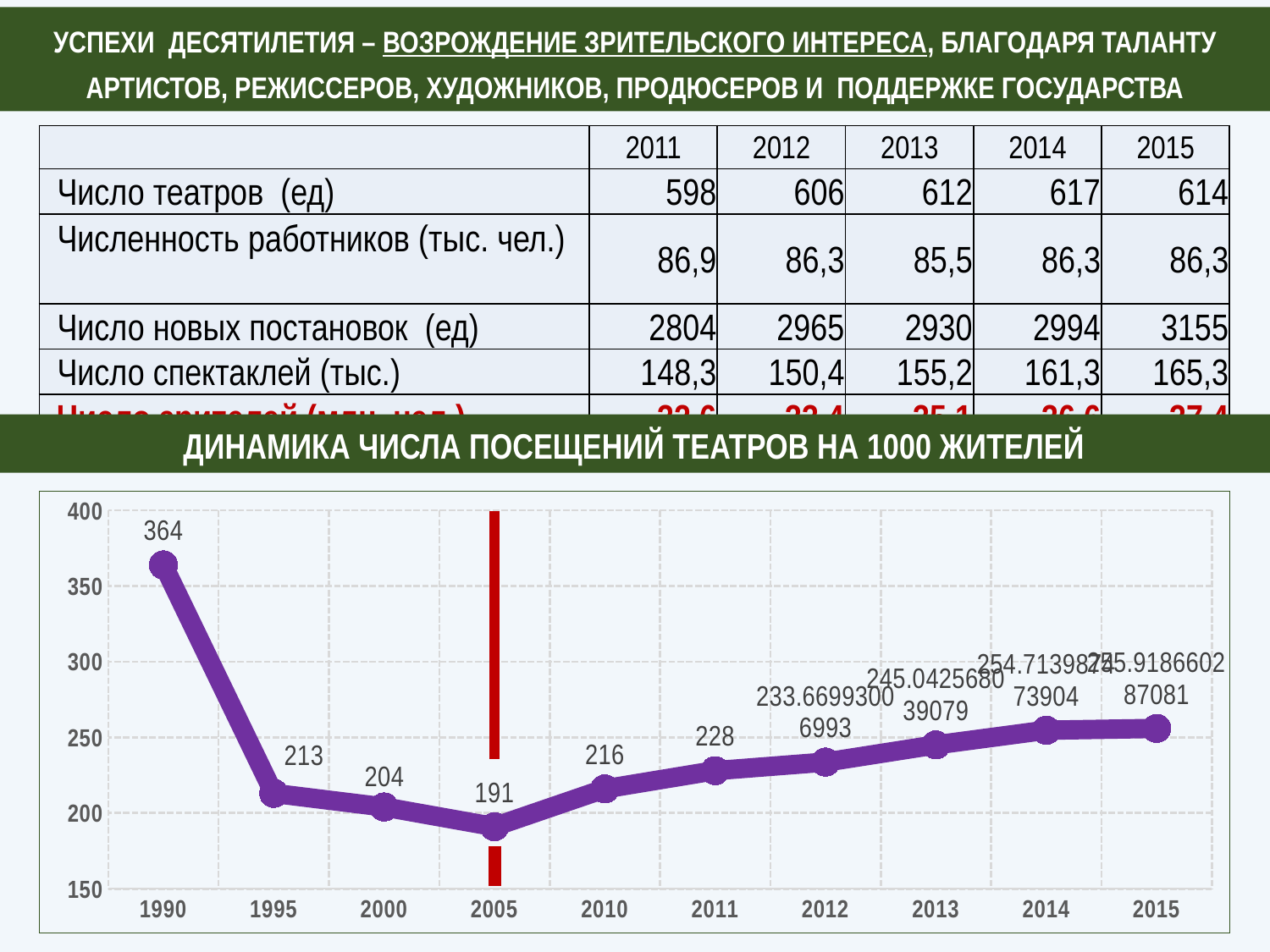
What is the difference between the values for 1990 and 1995? 151 Which year has the highest value on the line chart? 1990 How many years are plotted on the line chart? 10 Is the value for 2015 greater or less than 250? greater What is the value for 1990 on the line chart? 364 What is the value for 2000 on the line chart? 204 Which is larger, the value for 2010 or the value for 2000? 2010 What is the value for 2011 on the line chart? 228 What is the value for 2005 on the line chart? 191 What is the difference between the values for 2011 and 2010? 12 What kind of chart is shown under the heading 'ДИНАМИКА ЧИСЛА ПОСЕЩЕНИЙ ТЕАТРОВ НА 1000 ЖИТЕЛЕЙ'? line chart Which year has the lowest value on the line chart? 2005